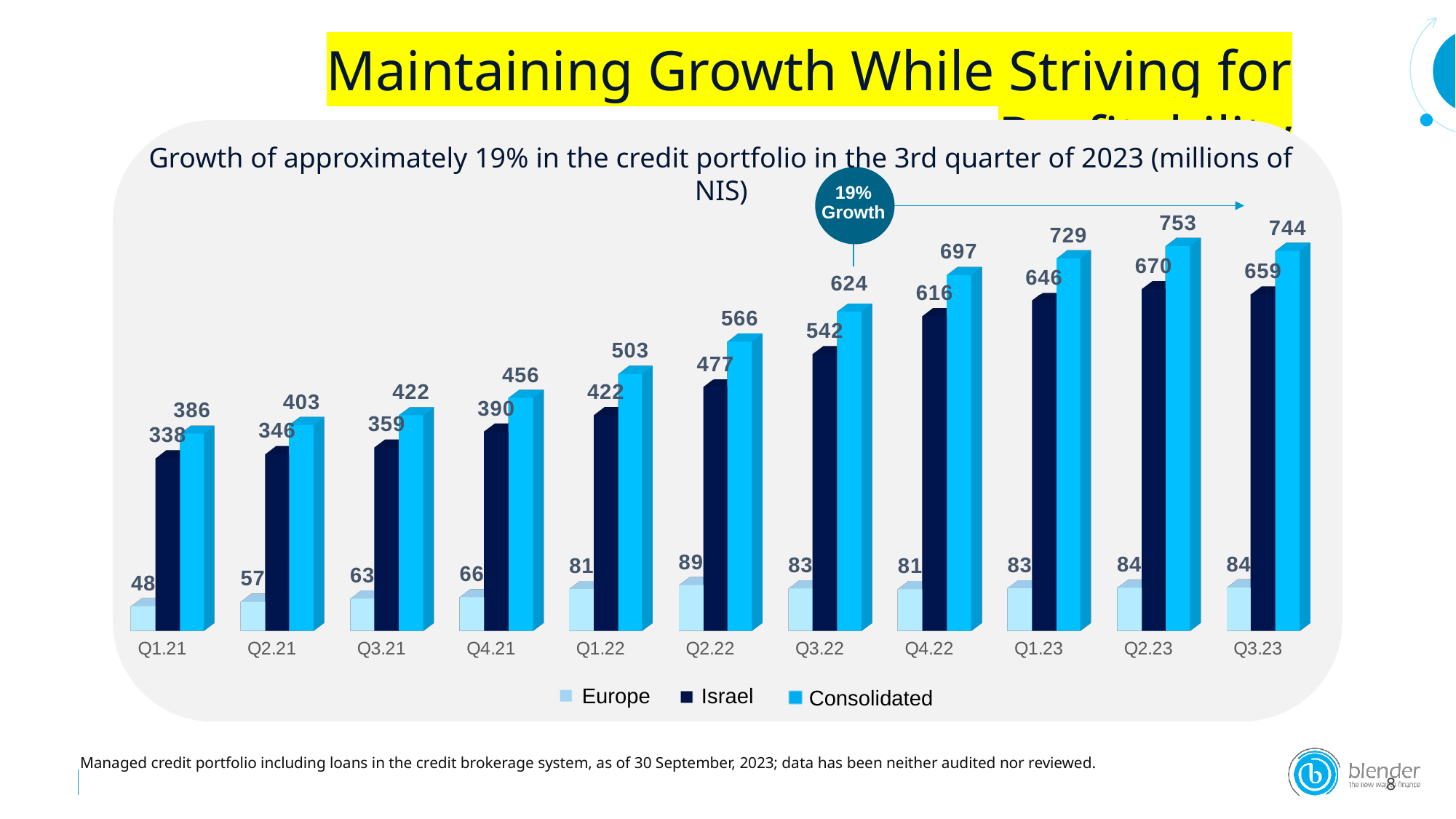
What is the difference between the Consolidated values for Q3.23 and Q3.22? 120 Do the Consolidated values generally rise or fall from Q1.21 to Q2.23? Rise In which quarter is the Israel value lowest? Q1.21 What kind of chart is shown on the slide? Bar chart What is the Europe value for Q1.21? 48 How many series does the legend list? 3 What is the Israel value for Q2.22? 477 Which is larger, the Israel value for Q2.23 or the Israel value for Q3.23? Q2.23 What is the Consolidated value for Q3.23? 744 Which series is shown in the darkest colour in the legend? Israel How many quarters are shown on the x axis? 11 In which quarter is the Consolidated value highest? Q2.23